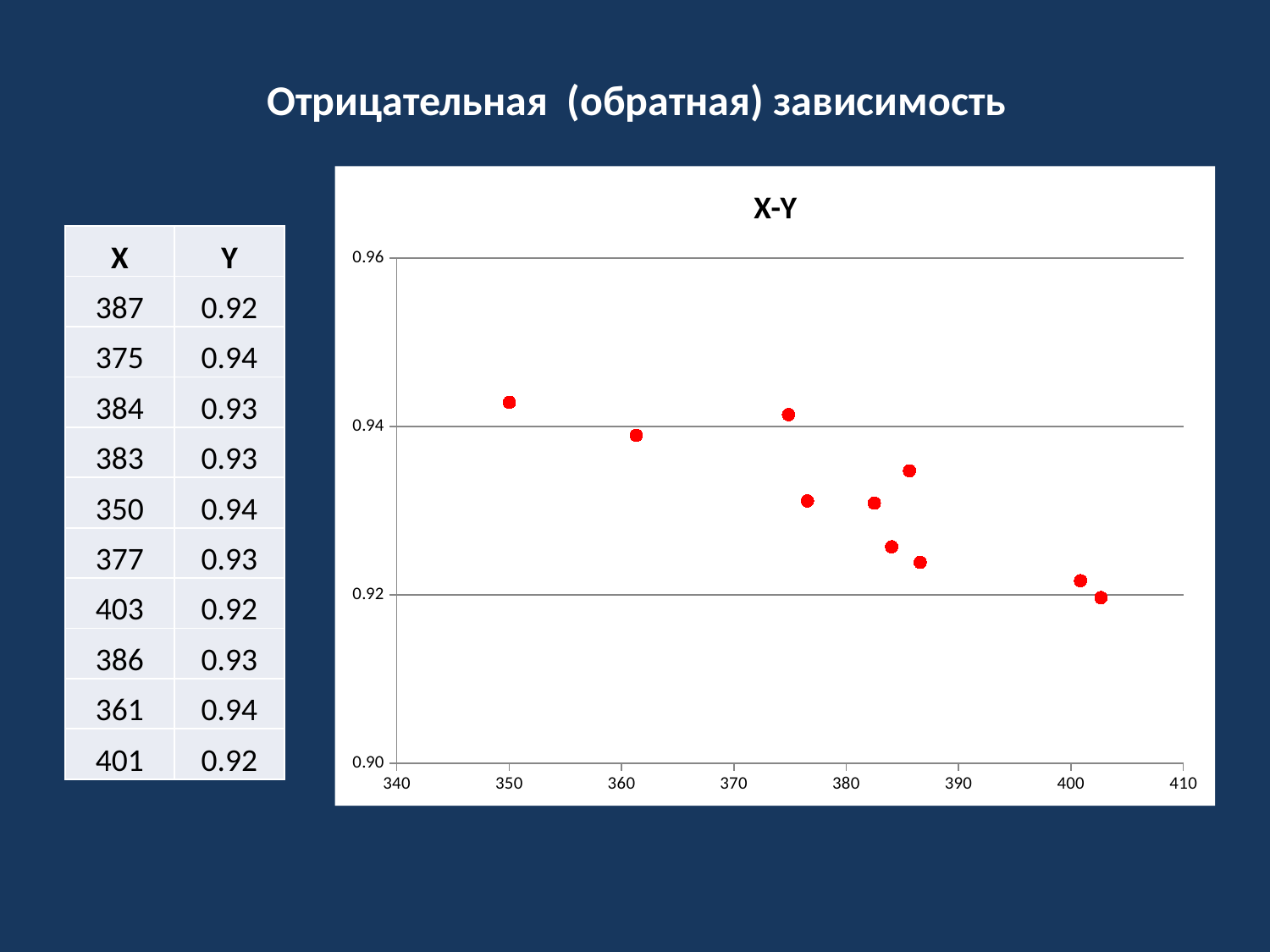
Which point has the largest X value in the chart? 403 What is the difference between the Y value at X = 350 and the Y value at X = 403? 0.02 Is the Y value for the point with X = 403 greater or less than 0.94? less What is the title of the chart? X-Y Which has the larger Y value: the point with X = 350 or the point with X = 403? 350 In the X-Y chart, do the Y values rise or fall as X increases? fall Which point has the smallest X value in the chart? 350 What kind of chart is shown on the slide? scatter chart How many data points are plotted in the X-Y chart? 10 What colour are the markers in the X-Y chart? red What is the Y value for the point with X = 403? 0.92 What is the Y value for the point with X = 350? 0.94